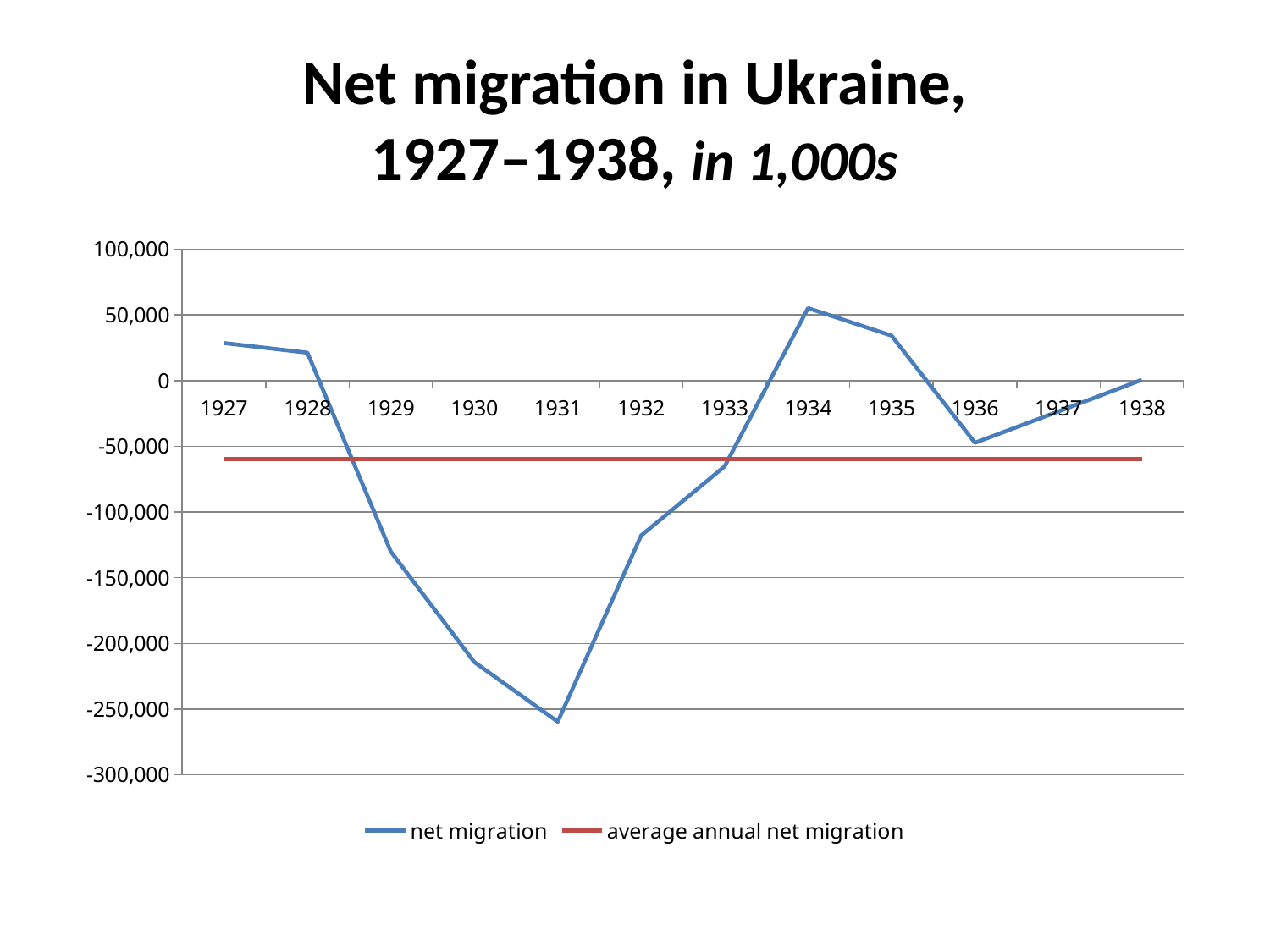
Is the net migration value for 1935 greater or less than 50,000? less Does net migration rise or fall from 1929 to 1931? fall What kind of chart is shown on the slide? line chart Is the net migration value for 1927 greater or less than 0? greater How many series does the legend list? 2 Is the average annual net migration line above or below -50,000? below In which year is net migration lowest? 1931 Which year has the larger net migration, 1934 or 1935? 1934 In which year is net migration highest? 1934 How many years are plotted along the x axis? 12